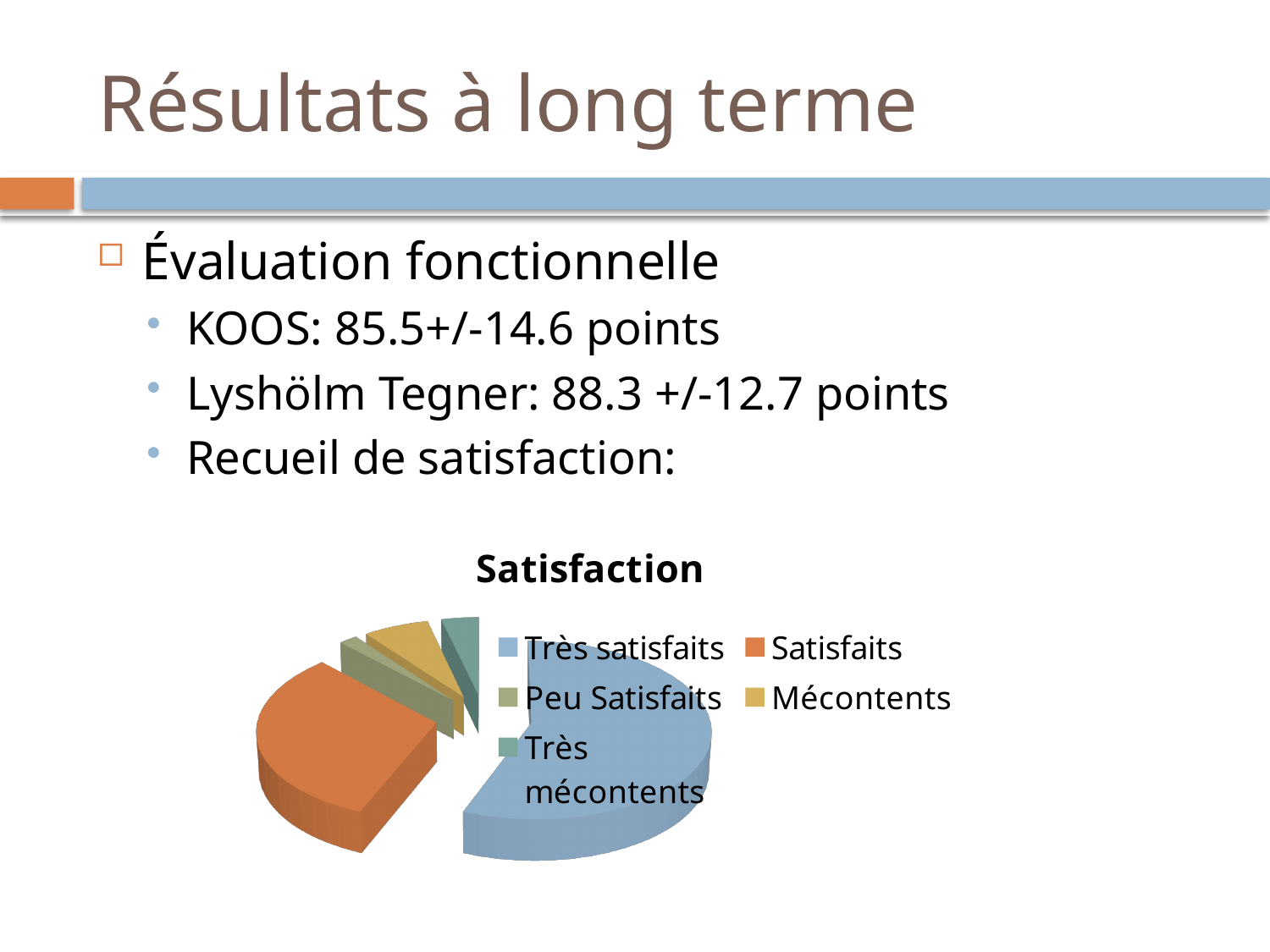
How many slices does the Satisfaction pie chart have? 5 What colour represents the Satisfaits category in the Satisfaction pie chart? orange In the Satisfaction pie chart, which slice is larger: Satisfaits or Peu Satisfaits? Satisfaits Which category has the smallest slice in the Satisfaction pie chart? Peu Satisfaits What kind of chart is shown on the slide? pie chart In the Satisfaction pie chart, which slice is larger: Mécontents or Très mécontents? Mécontents How many categories does the legend of the Satisfaction pie chart list? 5 In the Satisfaction pie chart, which slice is larger: Très satisfaits or Mécontents? Très satisfaits What is the title of the chart? Satisfaction